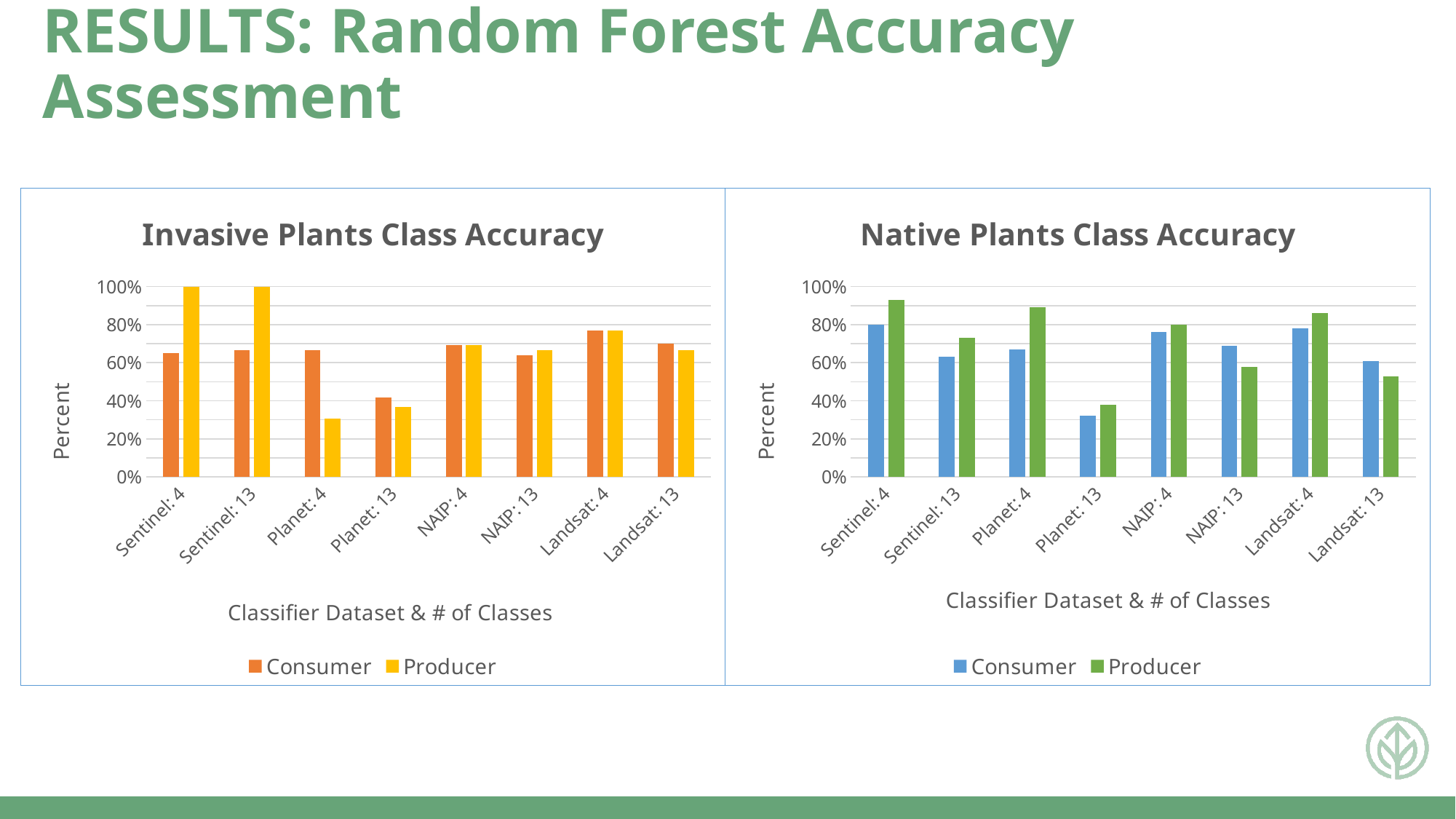
What is the x-axis title of the Native Plants Class Accuracy chart? Classifier Dataset & # of Classes How many series does the legend of the Invasive Plants Class Accuracy chart list? 2 In the Invasive Plants Class Accuracy chart, which category has the lowest Producer value? Planet: 4 In the Invasive Plants Class Accuracy chart, which category has the lowest Consumer value? Planet: 13 How many categories are shown on the x axis of the Native Plants Class Accuracy chart? 8 In the Invasive Plants Class Accuracy chart, is the Consumer value for Landsat: 4 greater or less than 60%? greater In the Native Plants Class Accuracy chart, is the Consumer value for Planet: 13 greater or less than 40%? less What kind of chart is the Invasive Plants Class Accuracy chart? bar chart In the Native Plants Class Accuracy chart, for NAIP: 13, which is larger, the Consumer value or the Producer value? Consumer In the Native Plants Class Accuracy chart, which category has the lowest Producer value? Planet: 13 In the Invasive Plants Class Accuracy chart, what is the Producer value for Sentinel: 4? 100% In the Invasive Plants Class Accuracy chart, is the Consumer value for Planet: 13 greater or less than 60%? less